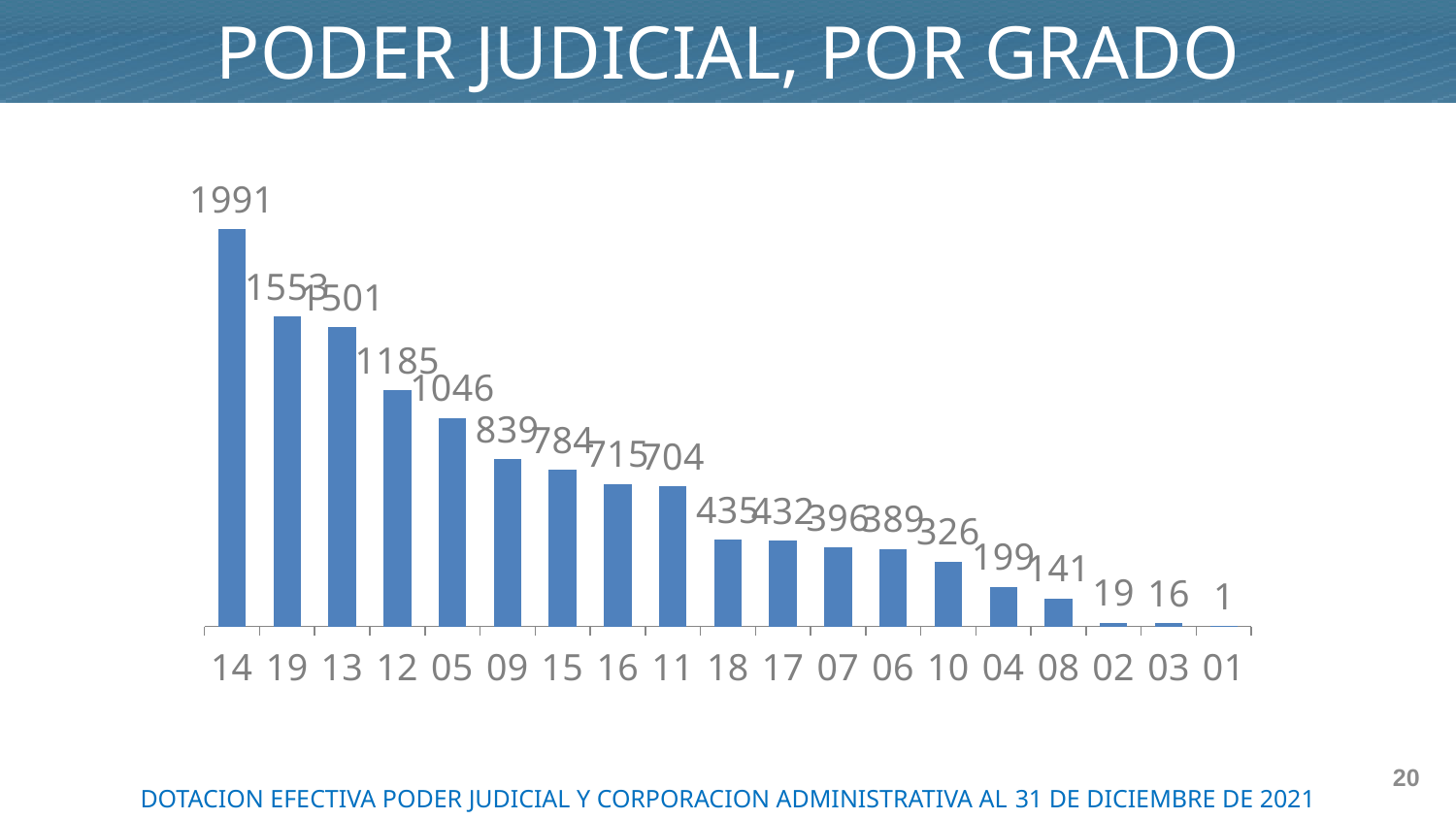
Do the values rise or fall from left to right along the x axis? fall Which grado has the highest value in the chart? 14 What is the value for grado 10? 326 Which has a larger value, grado 09 or grado 15? 09 What is the difference between the values for grado 14 and grado 12? 806 What kind of chart is shown on the slide? bar chart What is the value for grado 12? 1185 Which grado has the lowest value in the chart? 01 What is the value for grado 04? 199 What is the value for grado 14? 1991 How many grados (categories) are shown on the x axis? 19 What is the value for grado 08? 141